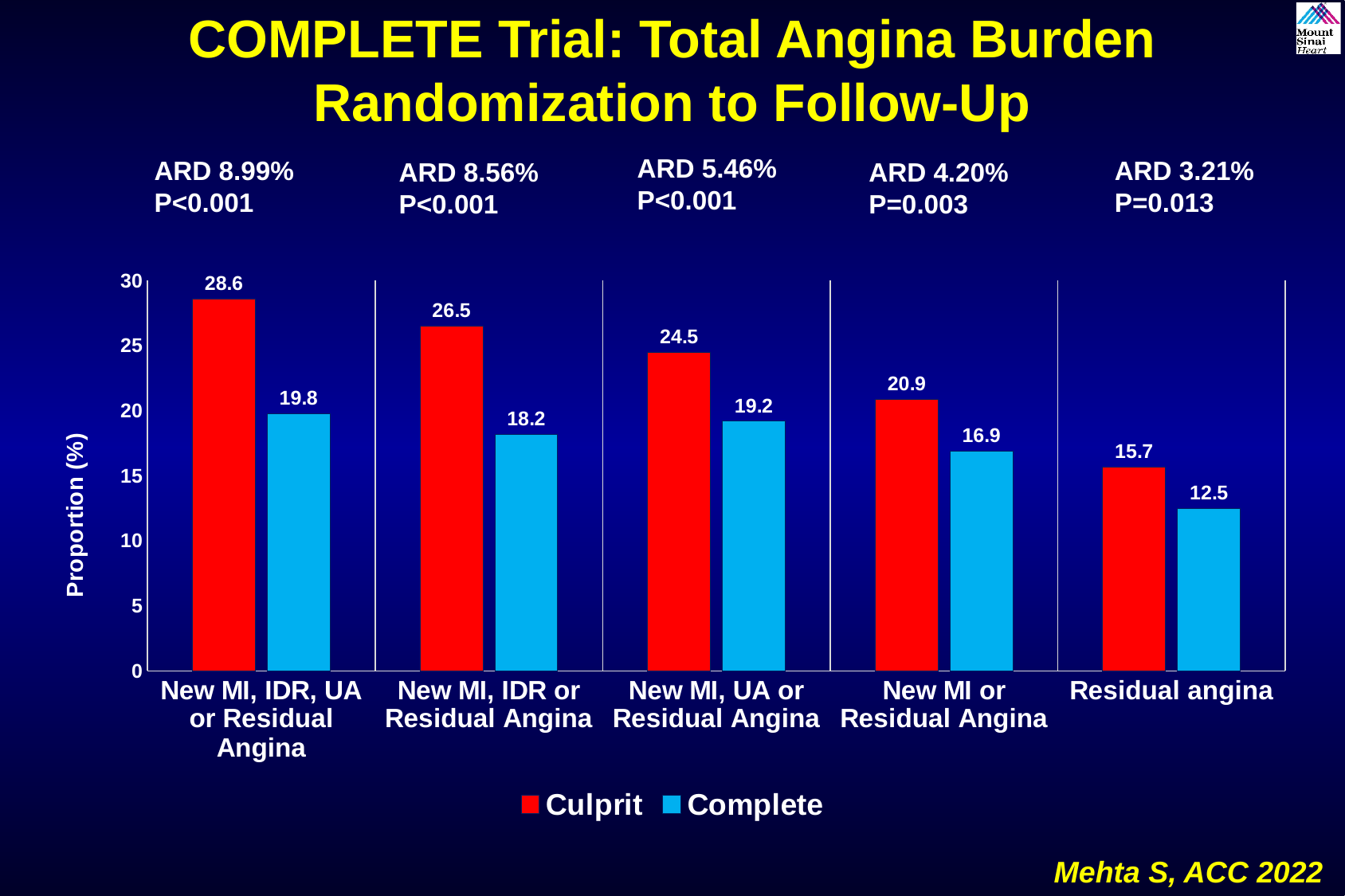
How many categories are shown on the x axis? 5 What is the Culprit value for the "Residual angina" category? 15.7 Which category has the highest Culprit value? New MI, IDR, UA or Residual Angina Which is larger for the "New MI or Residual Angina" category, the Culprit value or the Complete value? Culprit What is the difference between the Culprit and Complete values for the "New MI, IDR or Residual Angina" category? 8.3 What is the Complete value for the "New MI, UA or Residual Angina" category? 19.2 How many series does the legend list? 2 What is the label of the y axis? Proportion (%) Which category has the lowest Complete value? Residual angina What kind of chart is shown on the slide? Bar chart What is the Culprit value for the "New MI or Residual Angina" category? 20.9